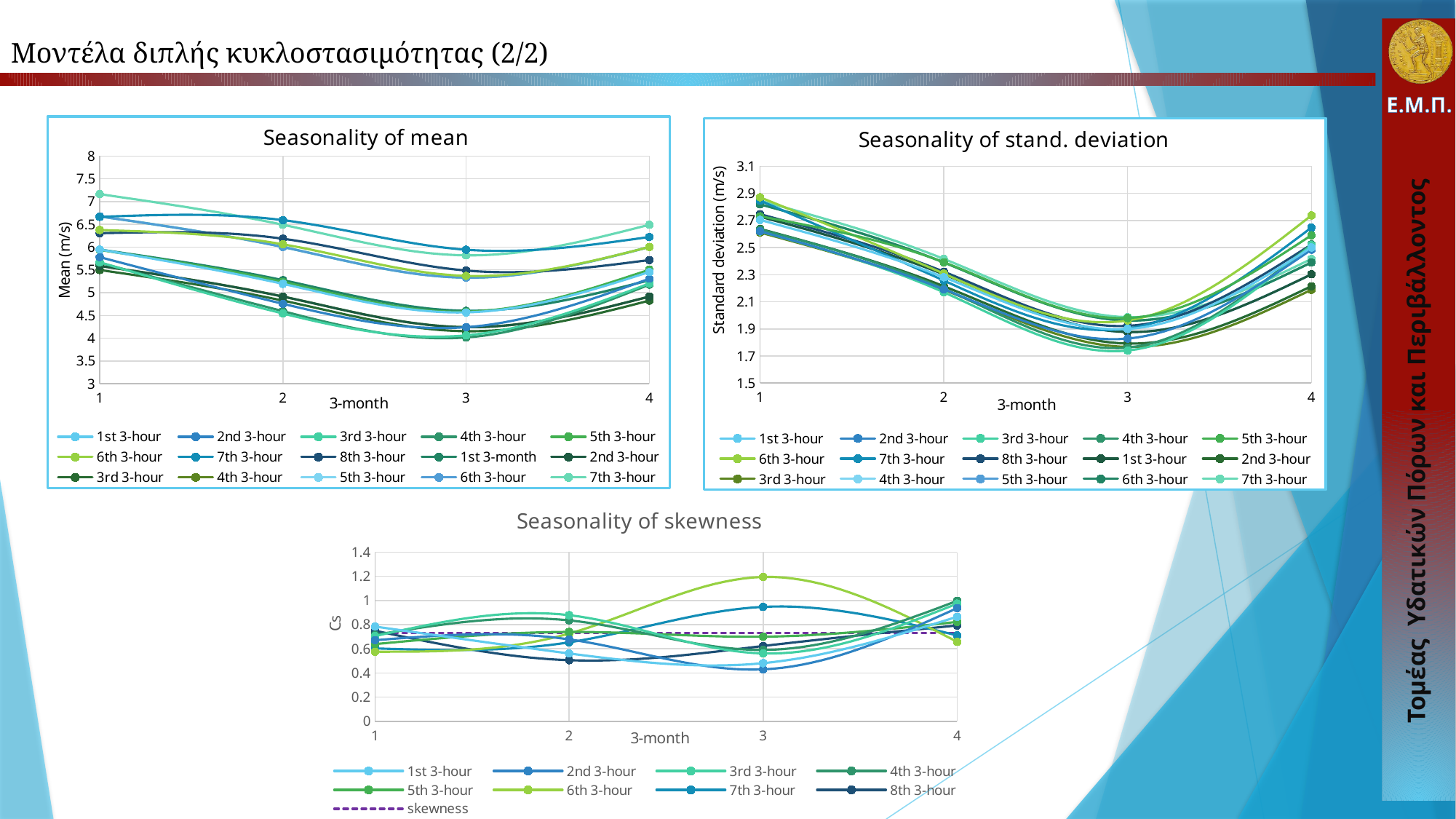
What kind of chart is the "Seasonality of mean" chart? line chart In the "Seasonality of stand. deviation" chart, do the values rise or fall from 3-month 3 to 3-month 4? rise In the "Seasonality of stand. deviation" chart, do the values rise or fall from 3-month 1 to 3-month 3? fall In the "Seasonality of skewness" chart, is the value of the 6th 3-hour series at 3-month 3 greater or less than 1? greater How many series does the legend of the "Seasonality of skewness" chart list? 9 How many series does the legend of the "Seasonality of mean" chart list? 15 What is the x-axis title of the "Seasonality of skewness" chart? 3-month In the "Seasonality of skewness" chart, how many points are there along the x axis? 4 In the "Seasonality of skewness" chart, which series has the highest value at 3-month 3? 6th 3-hour What is the y-axis title of the "Seasonality of stand. deviation" chart? Standard deviation (m/s)